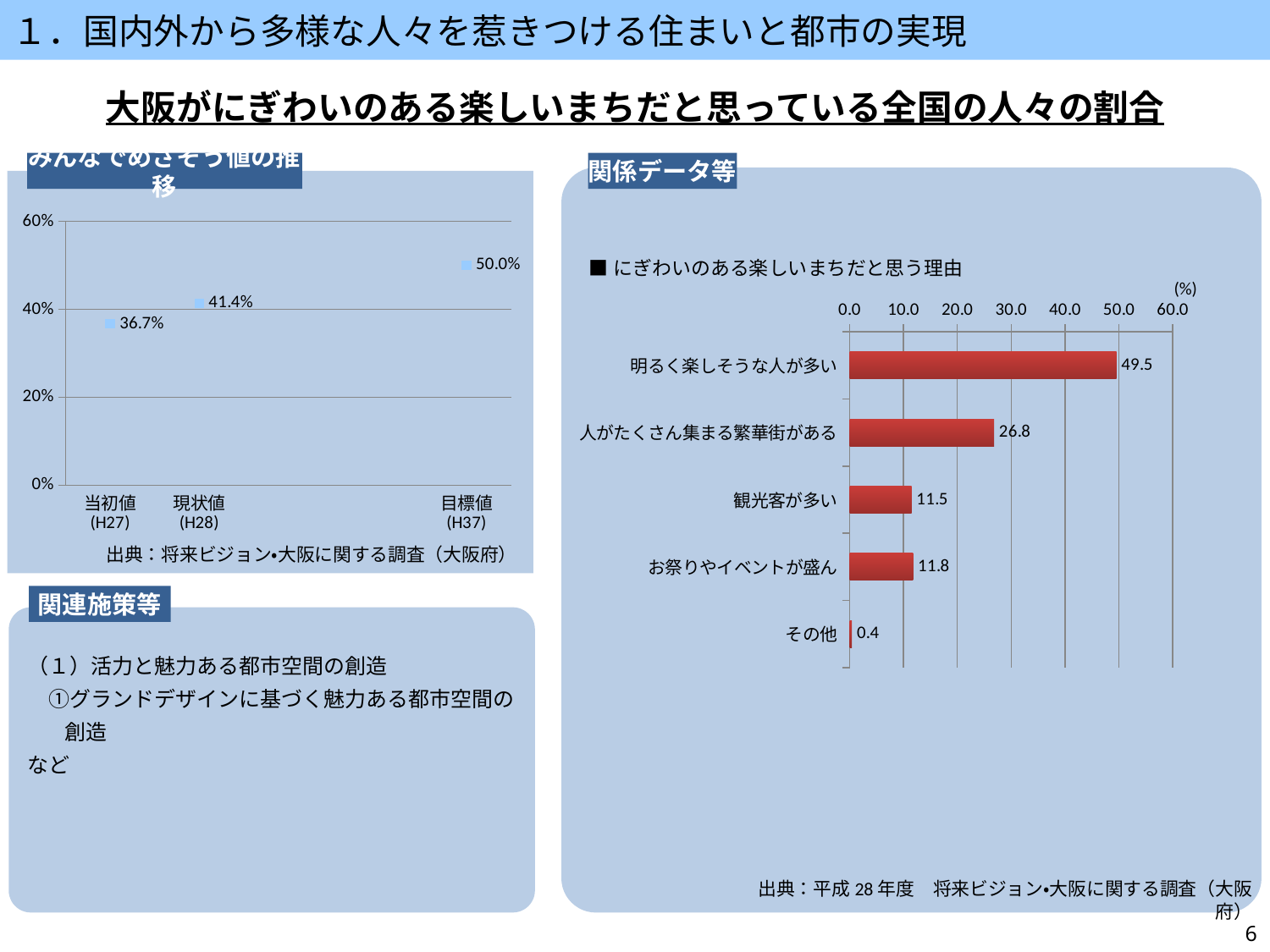
In the left chart (みんなでめざそう値の推移), what is the value for 現状値 (H28)? 41.4% In the right chart (にぎわいのある楽しいまちだと思う理由), what is the difference between 明るく楽しそうな人が多い and 人がたくさん集まる繁華街がある? 22.7 In the left chart (みんなでめざそう値の推移), what is the value for 目標値 (H37)? 50.0% In the left chart (みんなでめざそう値の推移), do the values rise or fall from 当初値 (H27) to 目標値 (H37)? rise In the right chart (にぎわいのある楽しいまちだと思う理由), how many categories are shown? 5 What kind of chart is the right chart (にぎわいのある楽しいまちだと思う理由)? bar chart In the left chart (みんなでめざそう値の推移), what is the difference between the 目標値 (H37) and the 当初値 (H27)? 13.3% In the right chart (にぎわいのある楽しいまちだと思う理由), what is the value for 観光客が多い? 11.5 In the right chart (にぎわいのある楽しいまちだと思う理由), which category has the lowest value? その他 In the right chart (にぎわいのある楽しいまちだと思う理由), which category has the highest value? 明るく楽しそうな人が多い In the left chart (みんなでめざそう値の推移), how many data points are plotted? 3 In the right chart (にぎわいのある楽しいまちだと思う理由), what is the value for 明るく楽しそうな人が多い? 49.5